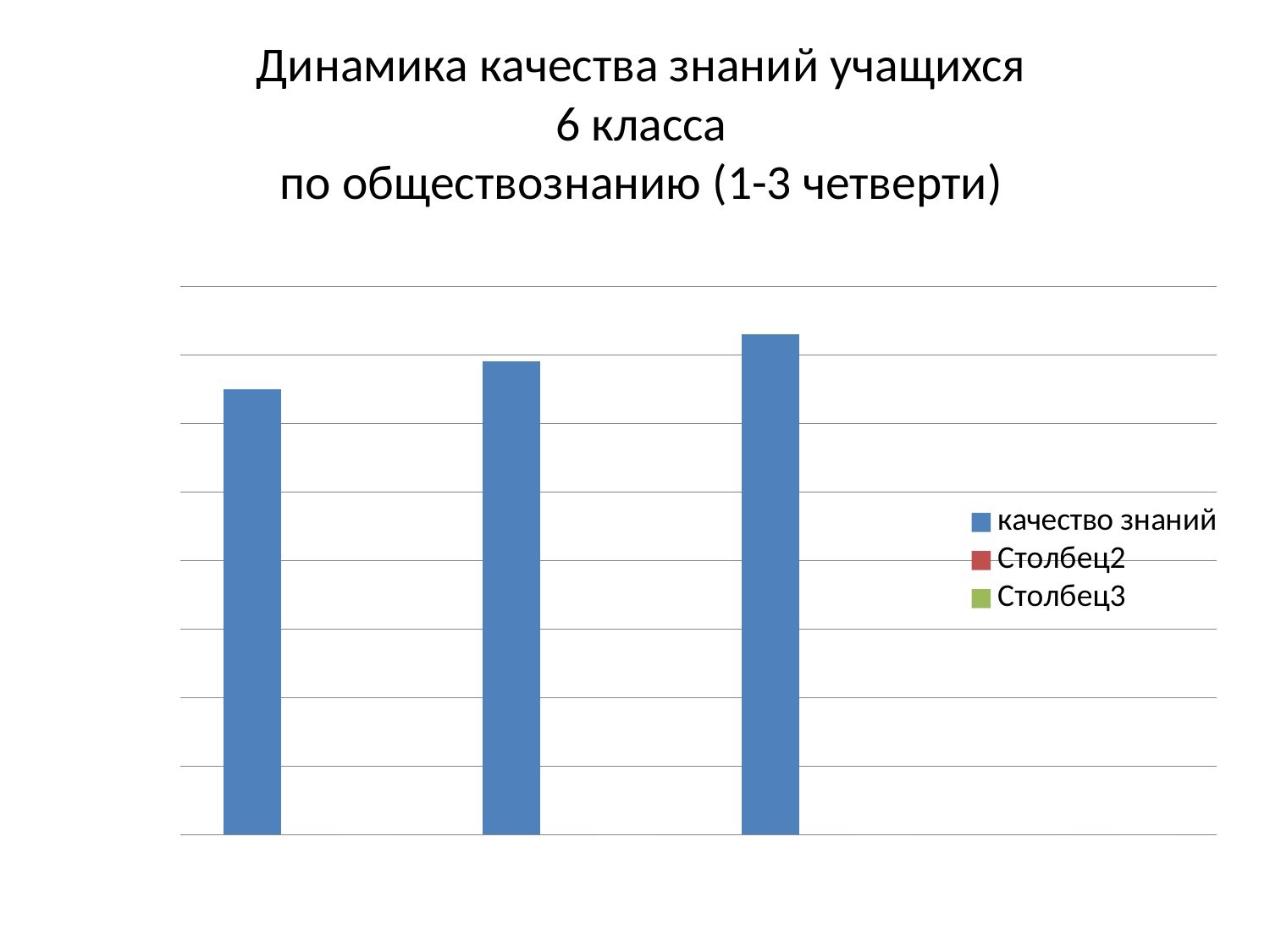
Which is larger, the middle bar or the leftmost bar? the middle bar What is the title of the chart on the slide? Динамика качества знаний учащихся 6 класса по обществознанию (1-3 четверти) Which bar is the tallest: the leftmost, the middle, or the rightmost? the rightmost Which is larger, the leftmost bar or the rightmost bar? the rightmost bar Which bar is the shortest: the leftmost, the middle, or the rightmost? the leftmost What is the name of the first series listed in the legend? качество знаний How many series does the chart legend list? 3 How many bars are plotted in the chart? 3 Do the bar values rise or fall from left to right across the chart? rise What kind of chart is shown on the slide? bar chart